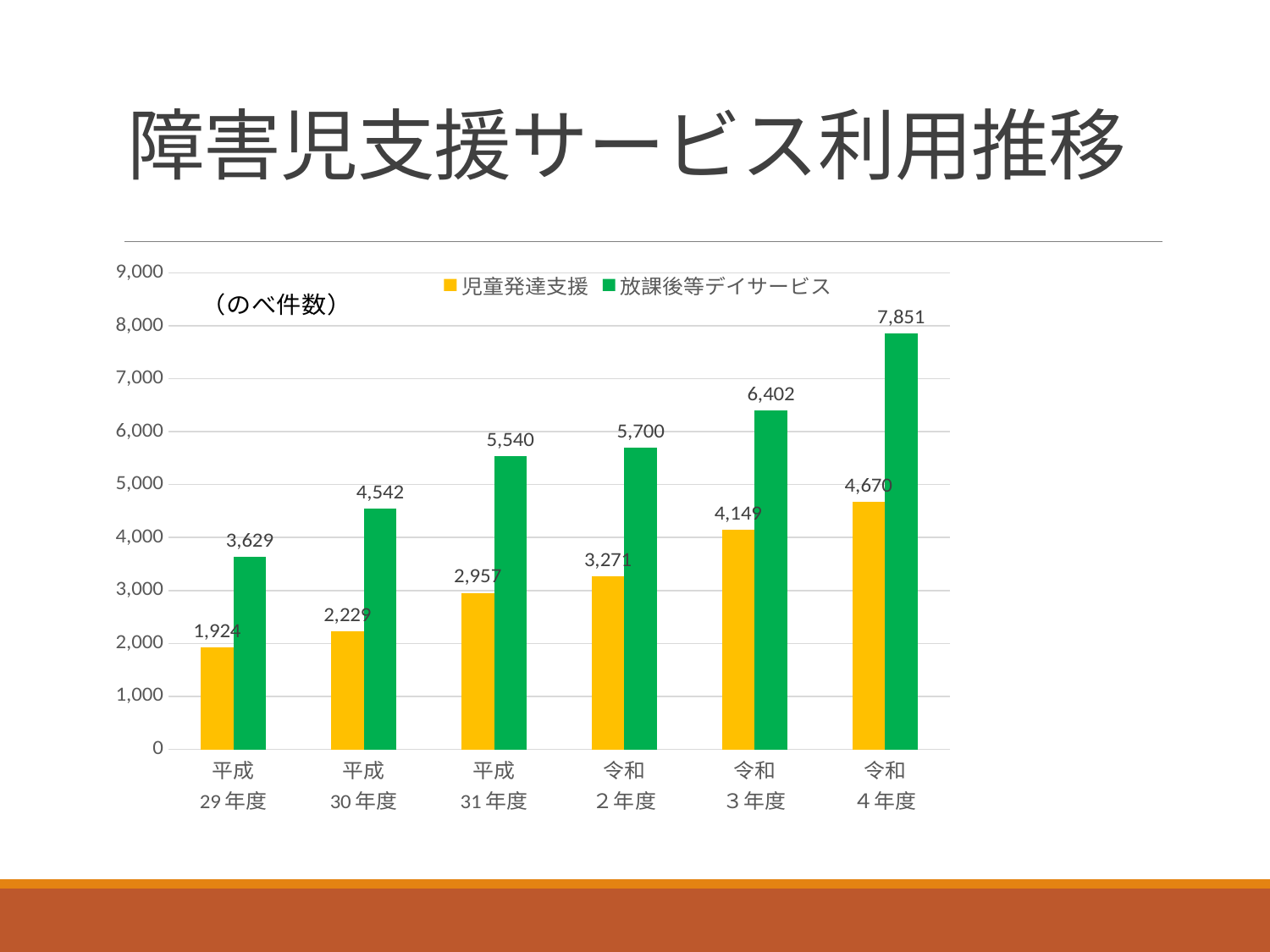
How many fiscal years are shown on the x axis? 6 Which is larger in 令和2年度: 児童発達支援 or 放課後等デイサービス? 放課後等デイサービス What is the value for 児童発達支援 in 平成29年度? 1,924 What type of chart is shown on the slide? bar chart How many series does the legend list? 2 Do the values for 放課後等デイサービス rise or fall from 平成29年度 to 令和4年度? rise What is the value for 放課後等デイサービス in 平成31年度? 5,540 What is the difference between 放課後等デイサービス and 児童発達支援 in 令和3年度? 2,253 In which year is the value for 放課後等デイサービス the lowest? 平成29年度 What is the value for 放課後等デイサービス in 令和4年度? 7,851 In which year is the value for 児童発達支援 the highest? 令和4年度 What is the title of the chart on the slide? 障害児支援サービス利用推移